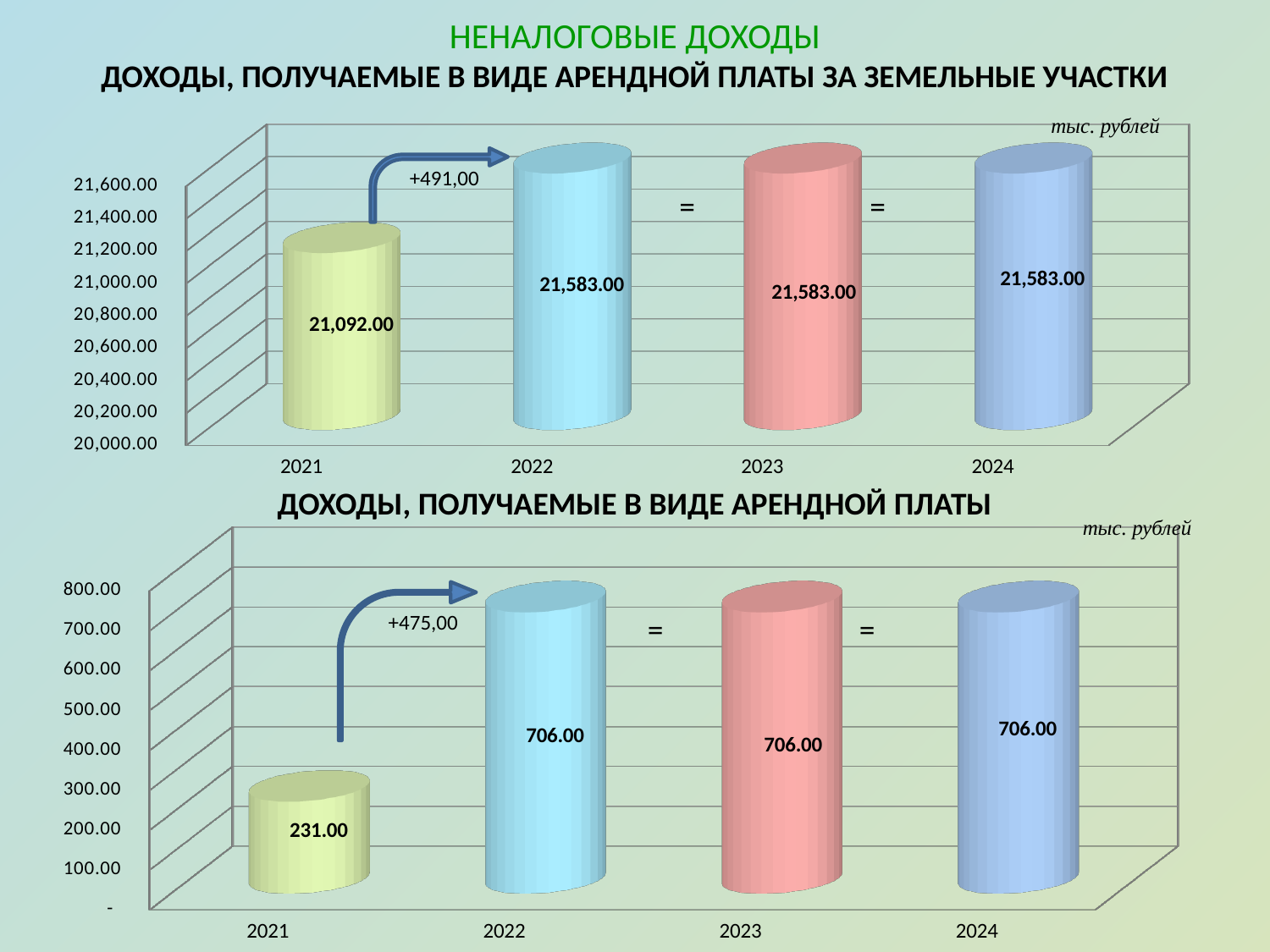
In the top chart (arrendal payments for land plots), what is the value for 2021? 21,092.00 In the bottom chart (arrendal payments), which year has the lowest value? 2021 In the bottom chart (arrendal payments), what unit is indicated in the top-right corner of the chart? тыс. рублей In the bottom chart (arrendal payments), what is the value for 2021? 231.00 What kind of chart is the bottom chart (arrendal payments)? Bar chart In the top chart (arrendal payments for land plots), which year has the lowest value? 2021 In the bottom chart (arrendal payments), what is the value for 2024? 706.00 In the bottom chart (arrendal payments), what is the difference between the 2022 value and the 2021 value? 475.00 In the bottom chart (arrendal payments), which is larger: the value for 2021 or the value for 2023? 2023 In the top chart (arrendal payments for land plots), what is the difference between the 2022 value and the 2021 value? 491.00 In the top chart (arrendal payments for land plots), what is the value for 2023? 21,583.00 In the top chart (arrendal payments for land plots), how many years are shown on the x axis? 4